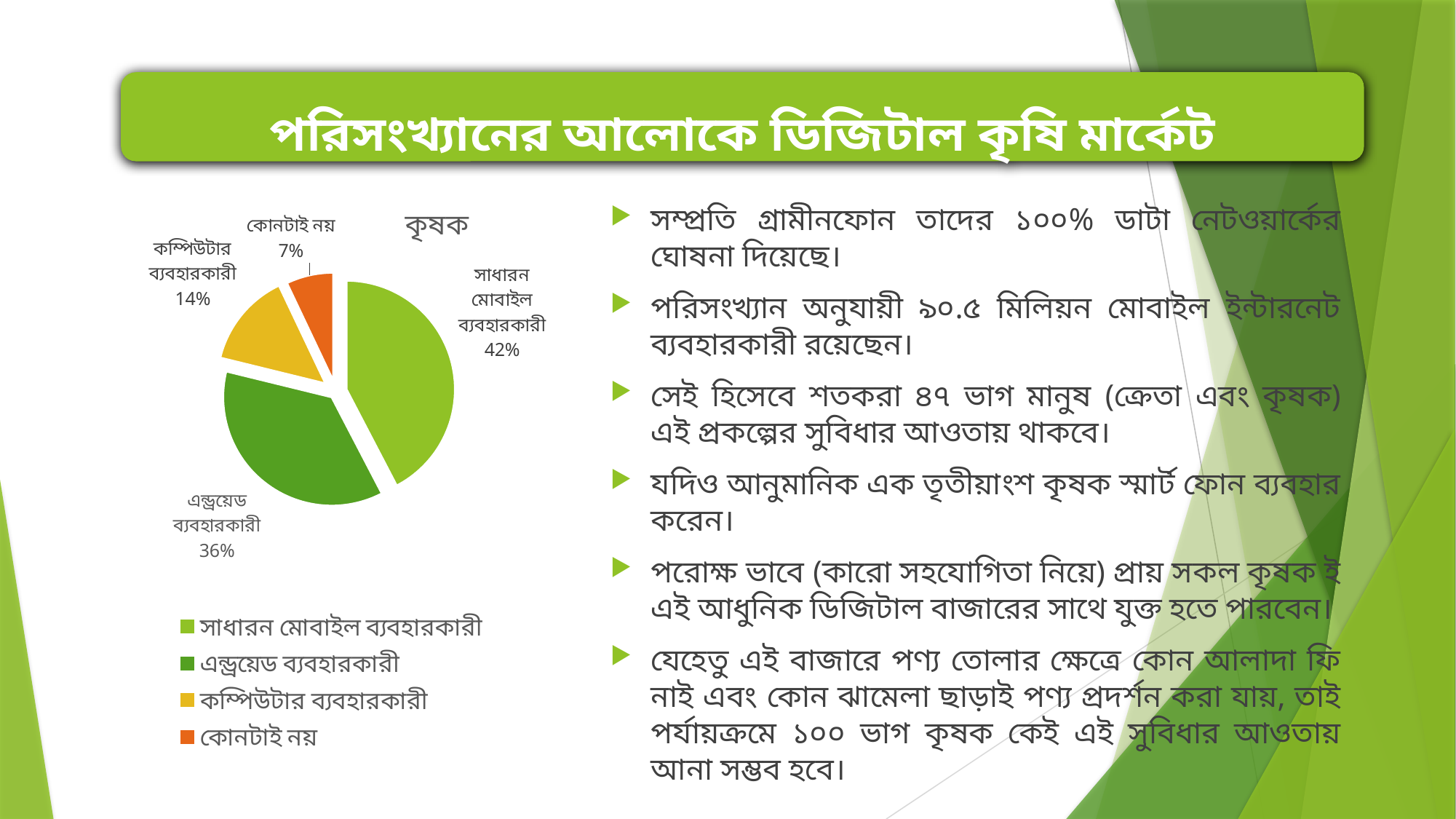
What percentage of the pie chart is labelled কম্পিউটার ব্যবহারকারী? 14% What percentage of the pie chart is labelled এন্ড্রয়েড ব্যবহারকারী? 36% What percentage of the pie chart is labelled কোনটাই নয়? 7% What percentage of the pie chart is labelled সাধারন মোবাইল ব্যবহারকারী? 42% What type of chart is shown on the slide? pie chart How many slices does the pie chart have? 4 Which category has the smallest slice in the pie chart? কোনটাই নয় What is the difference in percentage points between সাধারন মোবাইল ব্যবহারকারী and এন্ড্রয়েড ব্যবহারকারী? 6 What colour is the slice for কোনটাই নয় in the pie chart? orange What is the title of the pie chart? কৃষক Which is larger in the pie chart: কম্পিউটার ব্যবহারকারী or কোনটাই নয়? কম্পিউটার ব্যবহারকারী Which category has the largest slice in the pie chart? সাধারন মোবাইল ব্যবহারকারী